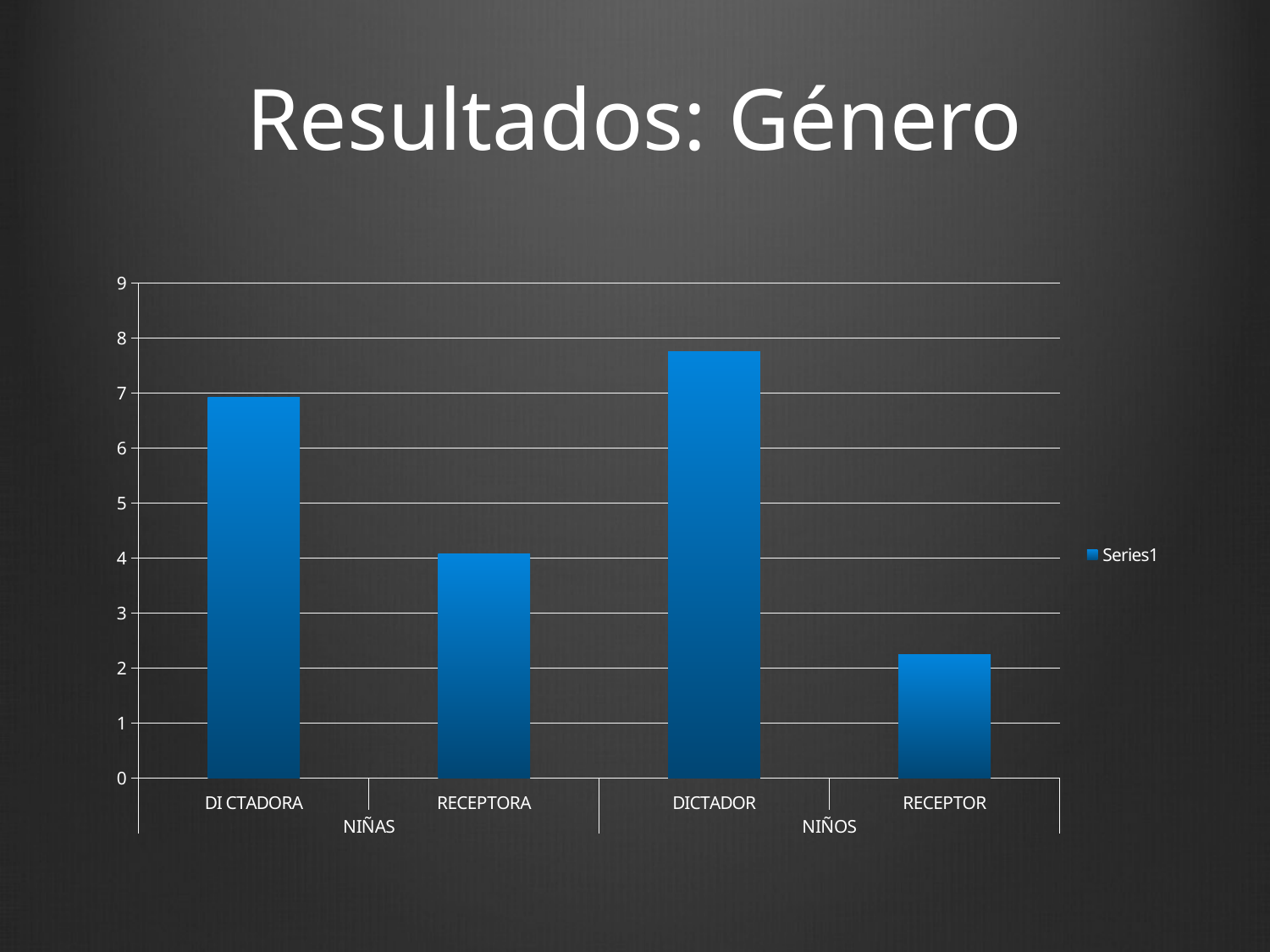
What kind of chart is shown on the slide? bar chart Which is larger, the value for DICTADORA or the value for RECEPTORA? DICTADORA How many series does the legend list? 1 Is the value for RECEPTOR greater or less than 3? less How many bars are plotted in the chart? 4 Which category has the highest bar? DICTADOR Is the value for DICTADORA greater or less than 6? greater Is the value for RECEPTORA greater or less than 5? less Which category has the lowest bar? RECEPTOR Which is larger, the value for DICTADOR or the value for RECEPTOR? DICTADOR What is the title of the slide? Resultados: Género